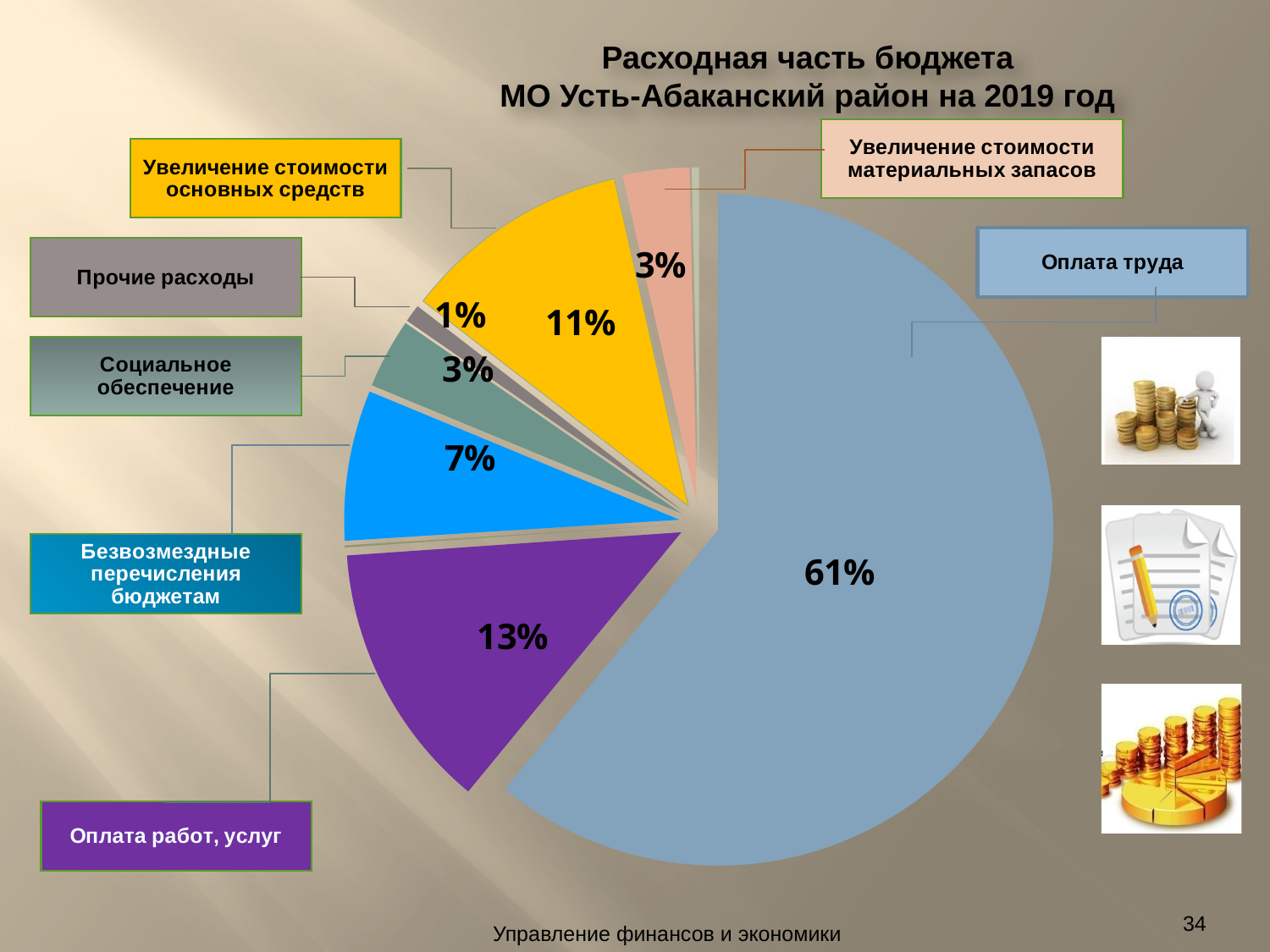
What share of the budget expenditure is Увеличение стоимости основных средств? 11% What share of the budget expenditure is Прочие расходы? 1% What share of the budget expenditure is Оплата работ, услуг? 13% Which is larger: Увеличение стоимости основных средств or Безвозмездные перечисления бюджетам? Увеличение стоимости основных средств What is the title of the chart? Расходная часть бюджета МО Усть-Абаканский район на 2019 год What kind of chart is shown on the slide? pie chart What is the difference in percentage points between Оплата труда and Оплата работ, услуг? 48 Which category has the largest share of the pie? Оплата труда How many slices does the pie chart have? 9